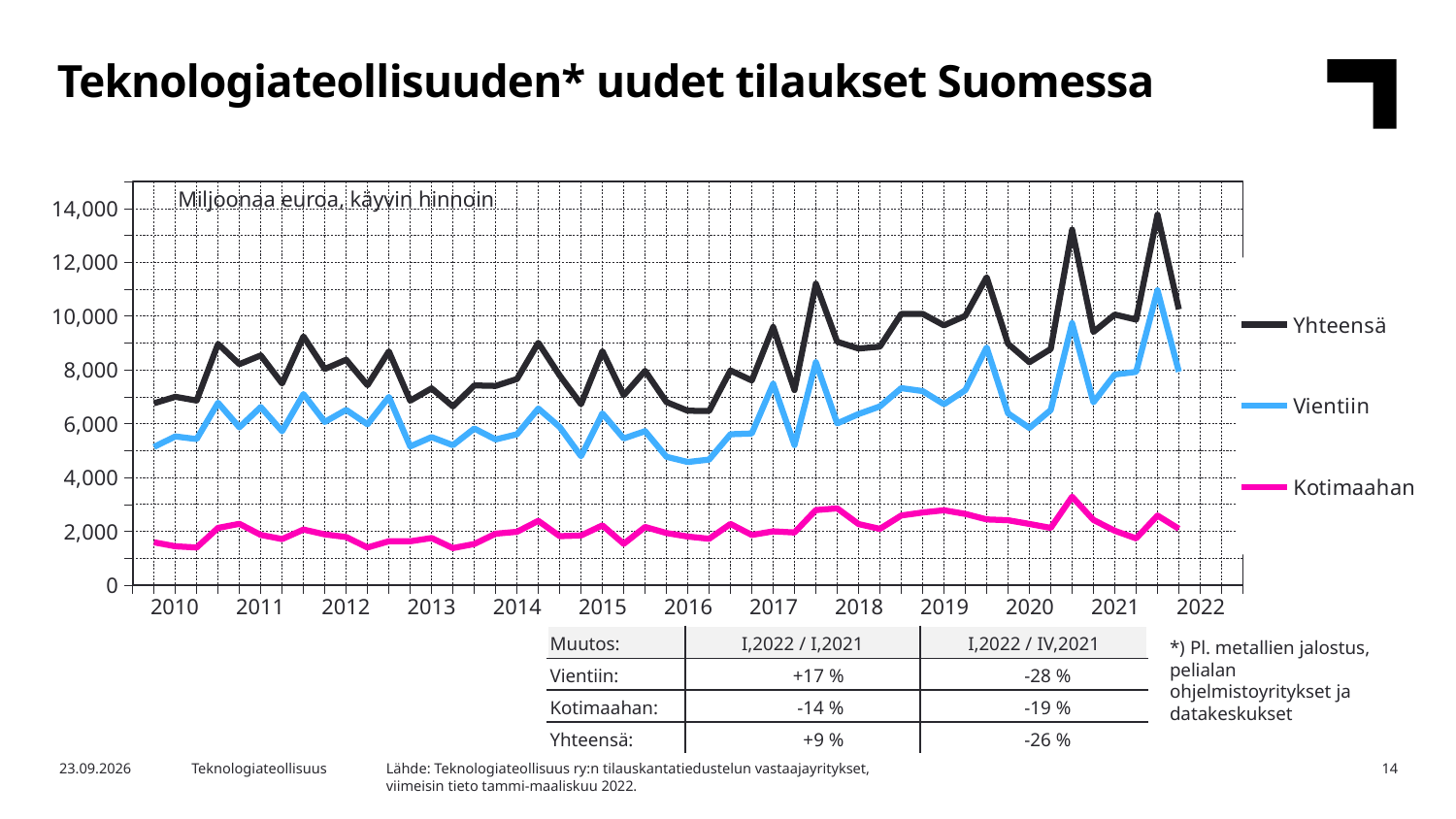
What unit note is printed inside the chart area? Miljoonaa euroa, käyvin hinnoin How many years are labeled on the x axis? 13 Which series reaches the highest value on the chart? Yhteensä What kind of chart is shown on the slide? line chart Is the peak value of Vientiin in late 2021 greater or less than 10,000? greater Is the peak value of Yhteensä in late 2021 greater or less than 12,000? greater Is the value for Vientiin at the start of 2016 greater or less than 6,000? less What are the three series listed in the chart legend? Yhteensä, Vientiin, Kotimaahan Which series has the lowest values throughout the chart? Kotimaahan How many series does the chart legend list? 3 Which series is larger in 2018, Vientiin or Kotimaahan? Vientiin